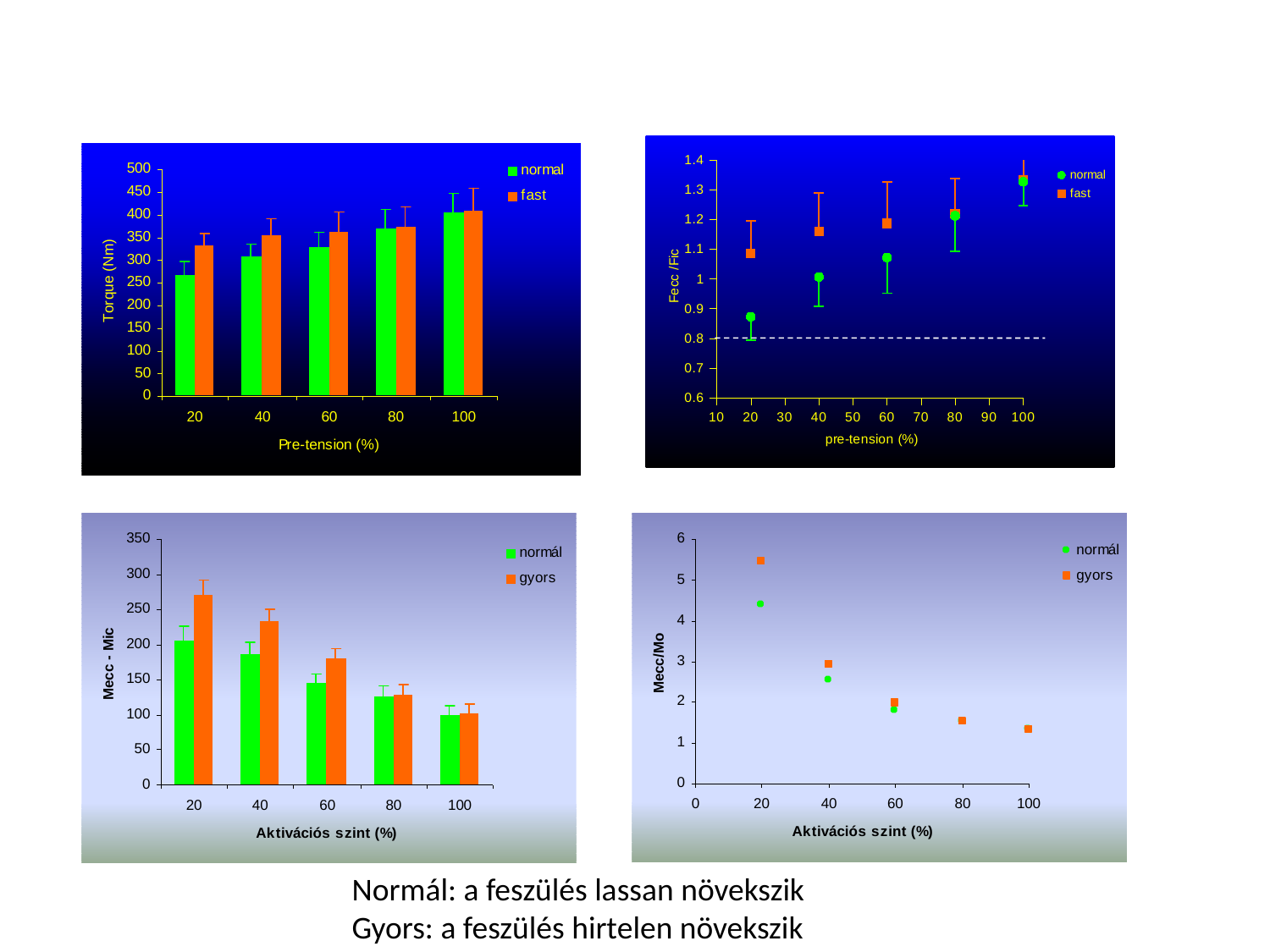
In the bottom-right chart, is the gyors Mecc/Mo value at 20% activation level greater or less than 5? greater In the bottom-right chart, which series has the larger Mecc/Mo value at 20% activation level, normál or gyors? gyors In the bottom-left chart, is the gyors value at 20% activation level greater or less than 250? greater In the bottom-left chart, do the Mecc - Mic values rise or fall as the activation level increases? fall In the top-left chart, at which pre-tension level is the normal torque highest? 100 What kind of chart is the top-left chart? bar chart How many series does the legend of the top-left chart list? 2 In the top-right chart, is the fast Fecc/Fic value at 100% pre-tension greater or less than 1.3? greater How many pre-tension categories are shown on the x axis of the top-left chart? 5 In the top-left chart, do the torque values rise or fall as pre-tension increases? rise